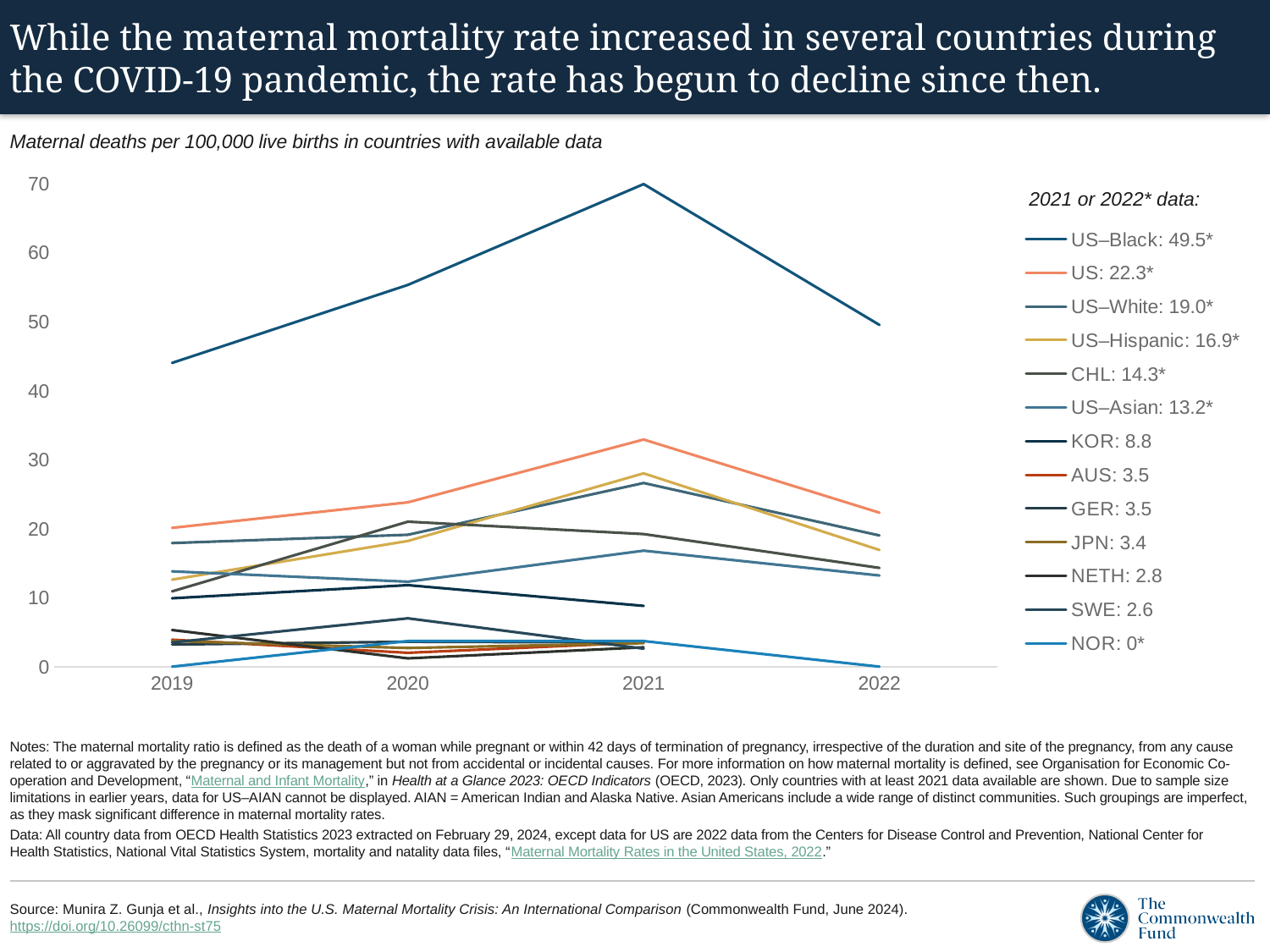
What kind of chart is shown on the slide? Line chart Which has the larger legend value, US or US–White? US According to the legend, what is the 2021 or 2022 value for CHL? 14.3* According to the legend, what is the 2021 or 2022 value for US–Black? 49.5* Is the value for US–Black in 2021 greater or less than 60? greater How many series does the legend list? 13 Which series has the lowest 2021 or 2022 value in the legend? NOR According to the legend, what is the 2021 or 2022 value for KOR? 8.8 What is the difference between the legend values for US–Black and US? 27.2 Does the US–Black line rise or fall from 2021 to 2022? Fall How many years are shown along the x axis? 4 Which series has the highest 2021 or 2022 value in the legend? US–Black